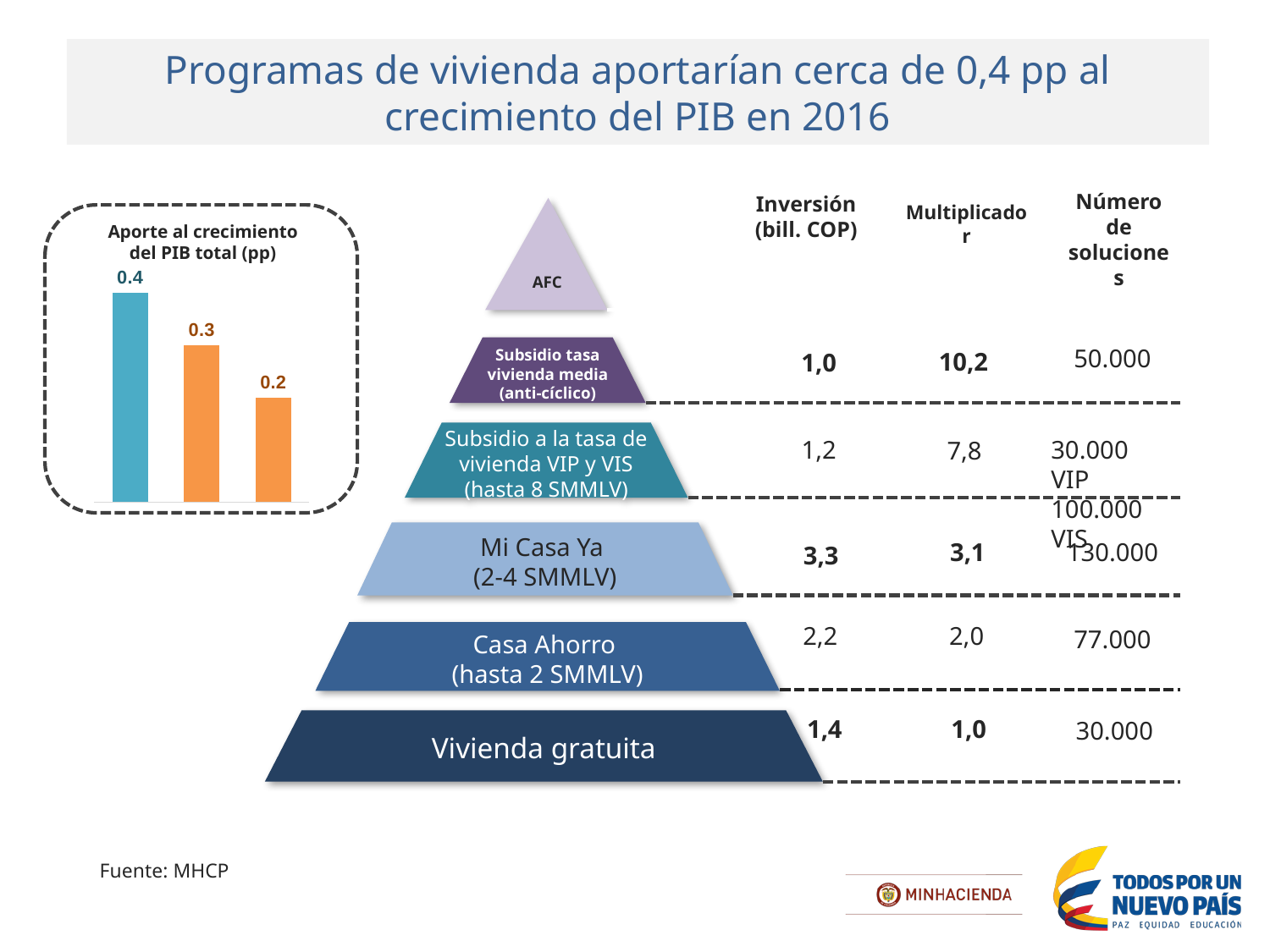
How many bars are plotted in the bar chart on the left of the slide? 3 In the bar chart on the left, what is the value of the leftmost bar? 0.4 In the bar chart on the left, do the values rise or fall from left to right? fall What kind of chart is shown in the dashed box on the left of the slide? bar chart In the bar chart on the left, what is the lowest value shown? 0.2 In the bar chart on the left, what is the difference between the first bar and the second bar? 0.1 What is the title of the bar chart on the left of the slide? Aporte al crecimiento del PIB total (pp) In the bar chart on the left, what is the value of the rightmost bar? 0.2 In the bar chart on the left, what is the highest value shown? 0.4 In the bar chart on the left, what is the difference between the highest and lowest values? 0.2 In the bar chart on the left, what colour is the tallest bar? blue In the bar chart on the left, what is the value of the middle bar? 0.3